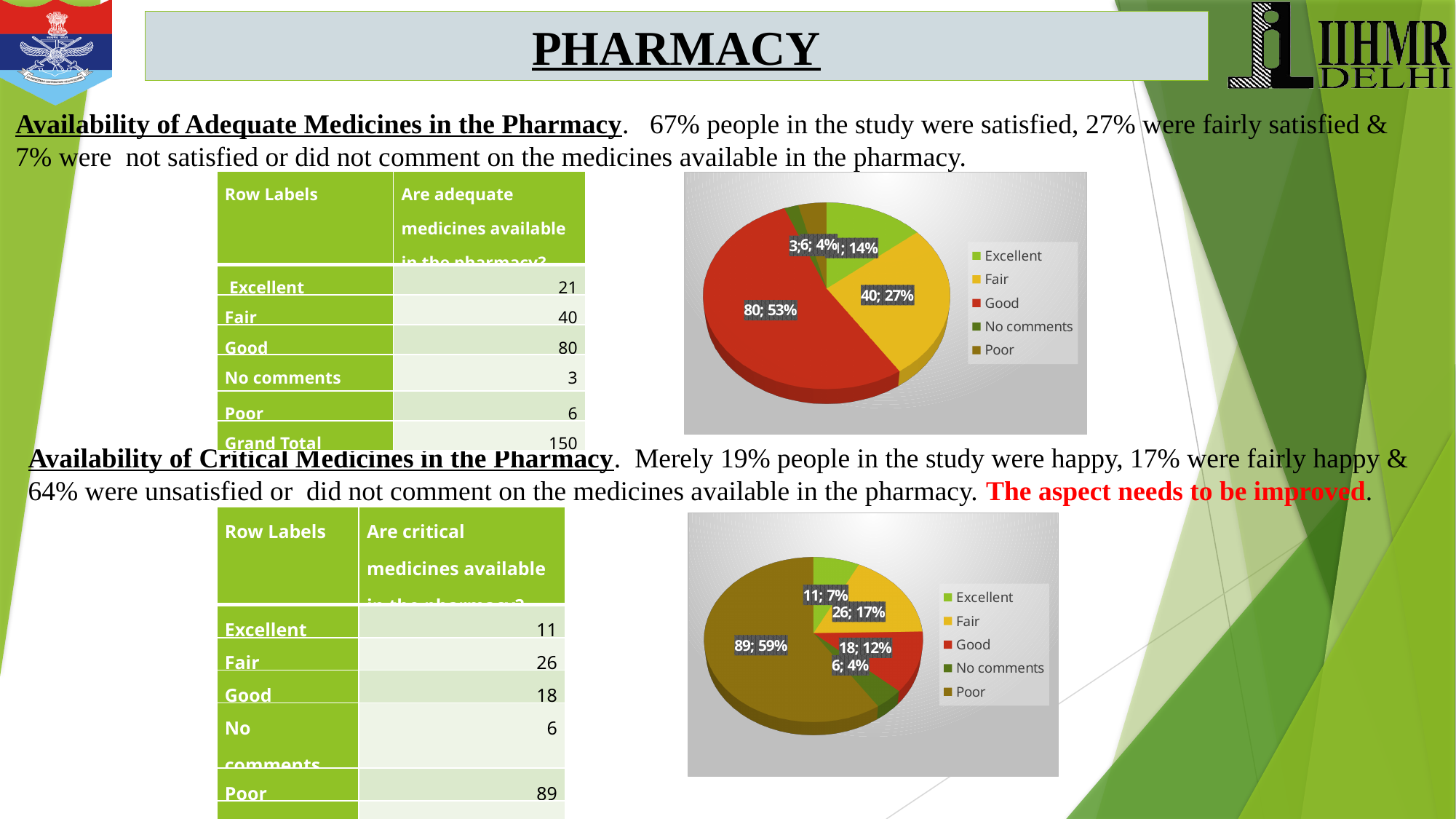
In the bottom pie chart (critical medicines), what is the value shown for Fair? 26 In the bottom pie chart, what colour is used for the Poor slice? olive/brown What type of chart is shown on the top right of the slide? pie chart In the top pie chart (adequate medicines), what is the value shown for Fair? 40 In the top pie chart (adequate medicines), what is the difference between the Good value and the Fair value? 40 How many entries does the legend of the top pie chart list? 5 In the bottom pie chart (critical medicines), which is larger, the Excellent value or the Good value? Good In the bottom pie chart (critical medicines), what share of the pie does the Poor slice represent? 59% In the bottom pie chart (critical medicines), what is the difference between the Poor value and the Excellent value? 78 In the top pie chart (adequate medicines), which category has the largest slice? Good In the top pie chart (adequate medicines), what share of the pie does the Good slice represent? 53% In the bottom pie chart (critical medicines), which category has the largest slice? Poor